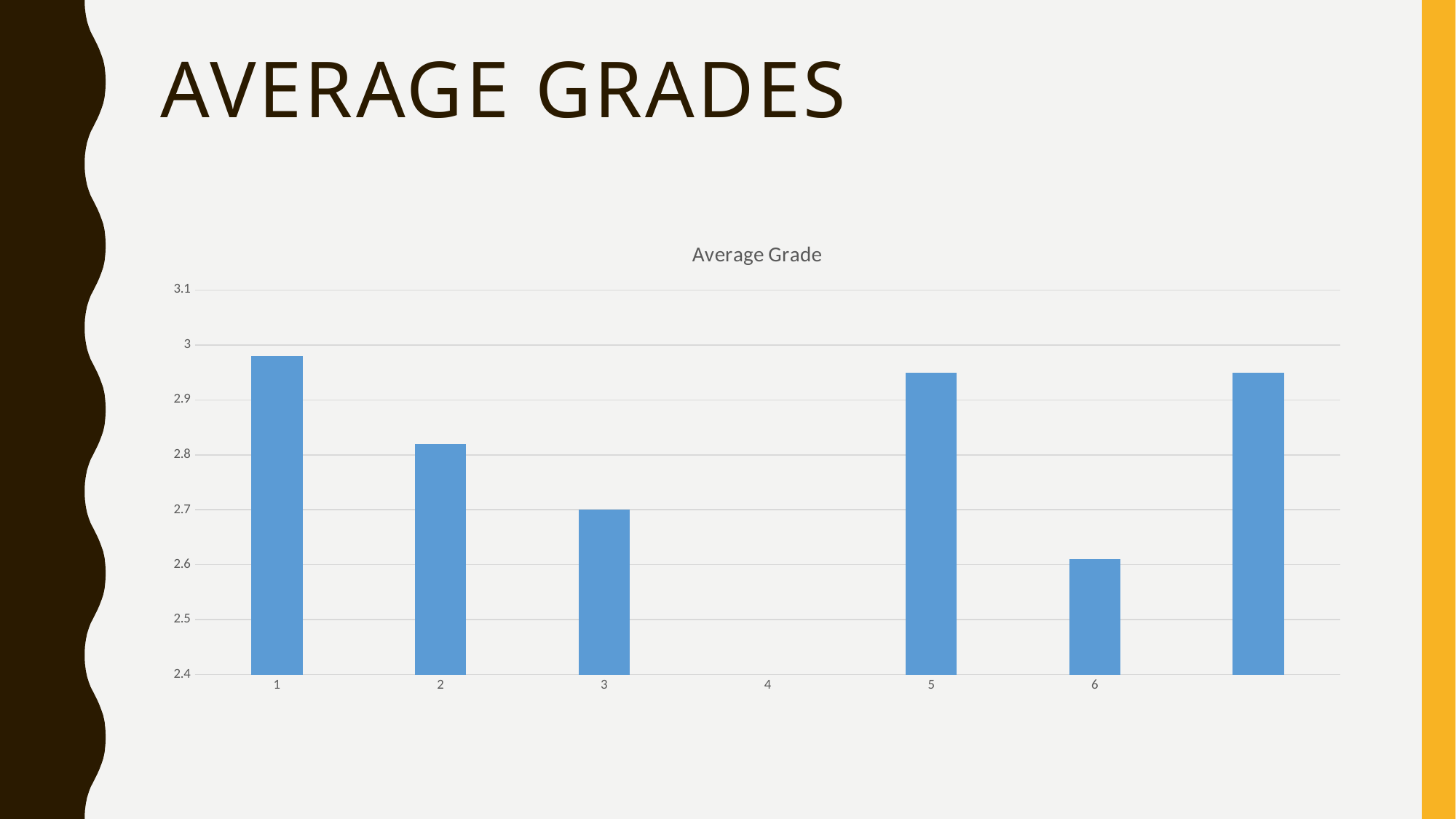
Which has a higher average grade, category 2 or category 3? 2 Which category has the highest average grade? 1 What kind of chart is shown on the slide? bar chart Which category has the lowest average grade? 6 Is the value for category 2 greater or less than 2.9? less What is the average grade for category 3? 2.7 Which has a higher average grade, category 5 or category 6? 5 What is the title of the chart? Average Grade Is the value for category 1 greater or less than 3? less Is the value for category 6 greater or less than 2.7? less